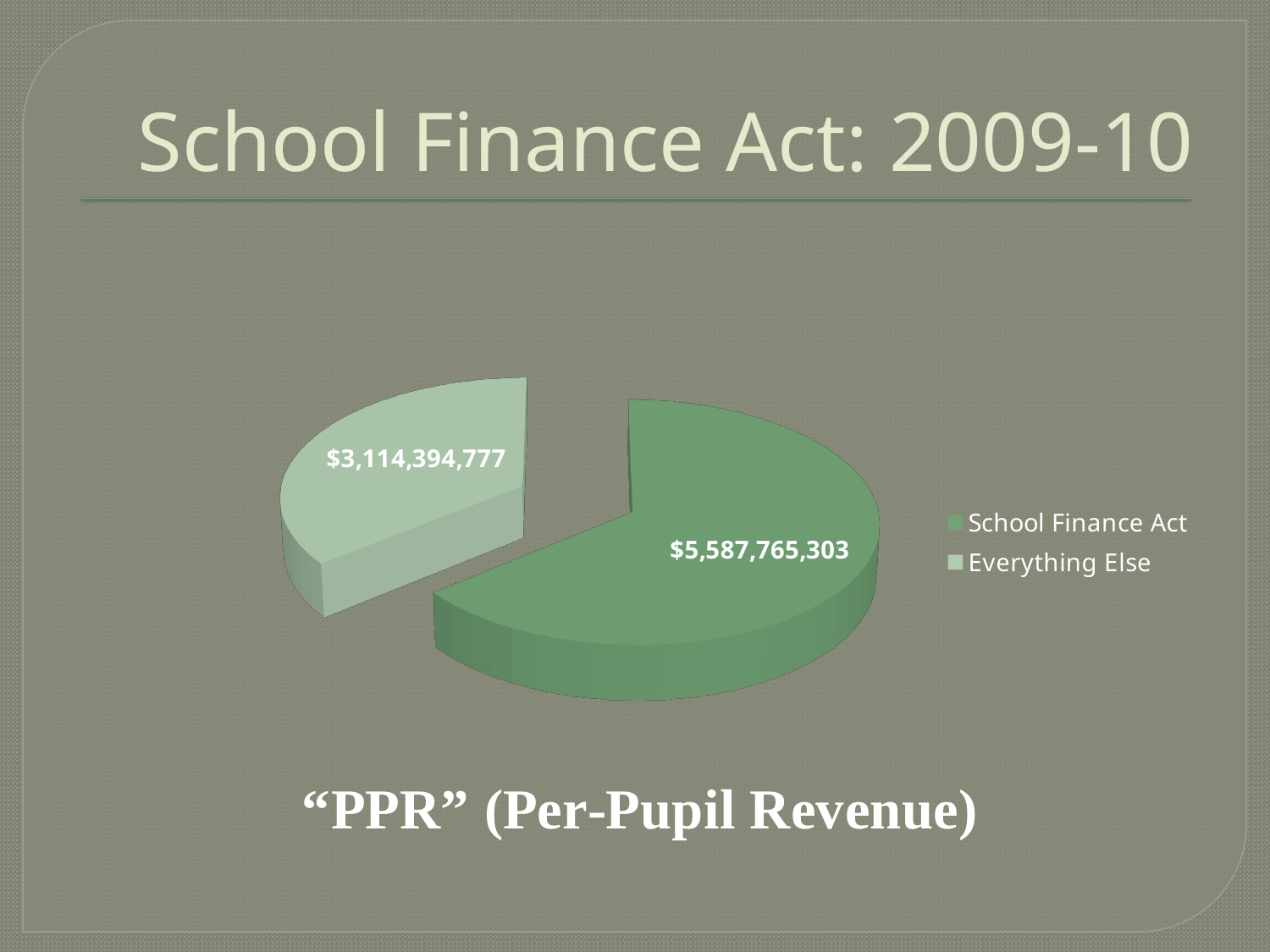
Which slice is the smallest? Everything Else What type of chart is shown on the slide? Pie chart What caption appears below the pie chart? "PPR" (Per-Pupil Revenue) How many entries does the legend list? 2 What is the value of the School Finance Act slice? $5,587,765,303 What is the total of the two slices in the pie chart? $8,702,160,080 What is the title of the slide containing the chart? School Finance Act: 2009-10 Which is larger, School Finance Act or Everything Else? School Finance Act What is the difference between the School Finance Act value and the Everything Else value? $2,473,370,526 How many slices does the pie chart have? 2 Which slice is the largest? School Finance Act What is the value of the Everything Else slice? $3,114,394,777